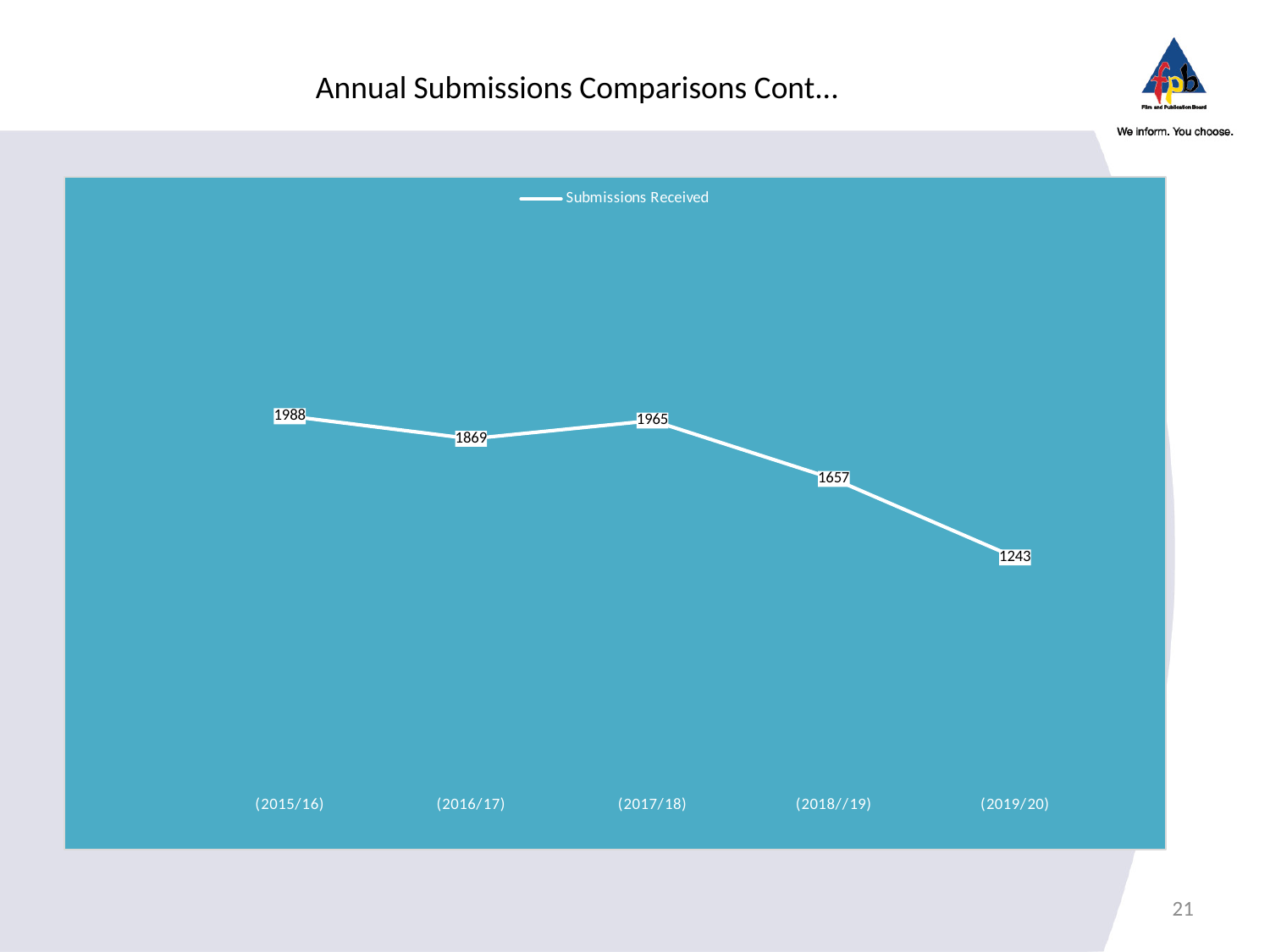
Which period has the highest number of Submissions Received? (2015/16) Which period has the lowest number of Submissions Received? (2019/20) What is the difference in Submissions Received between (2015/16) and (2019/20)? 745 What is the difference in Submissions Received between (2017/18) and (2018//19)? 308 Do the Submissions Received values generally rise or fall from (2015/16) to (2019/20)? Fall Which period has more Submissions Received, (2016/17) or (2018//19)? (2016/17) What is the value of Submissions Received for (2017/18)? 1965 How many series does the legend list? 1 What is the value of Submissions Received for (2019/20)? 1243 What kind of chart is shown on the slide? Line chart How many periods are plotted on the chart? 5 What is the value of Submissions Received for (2015/16)? 1988